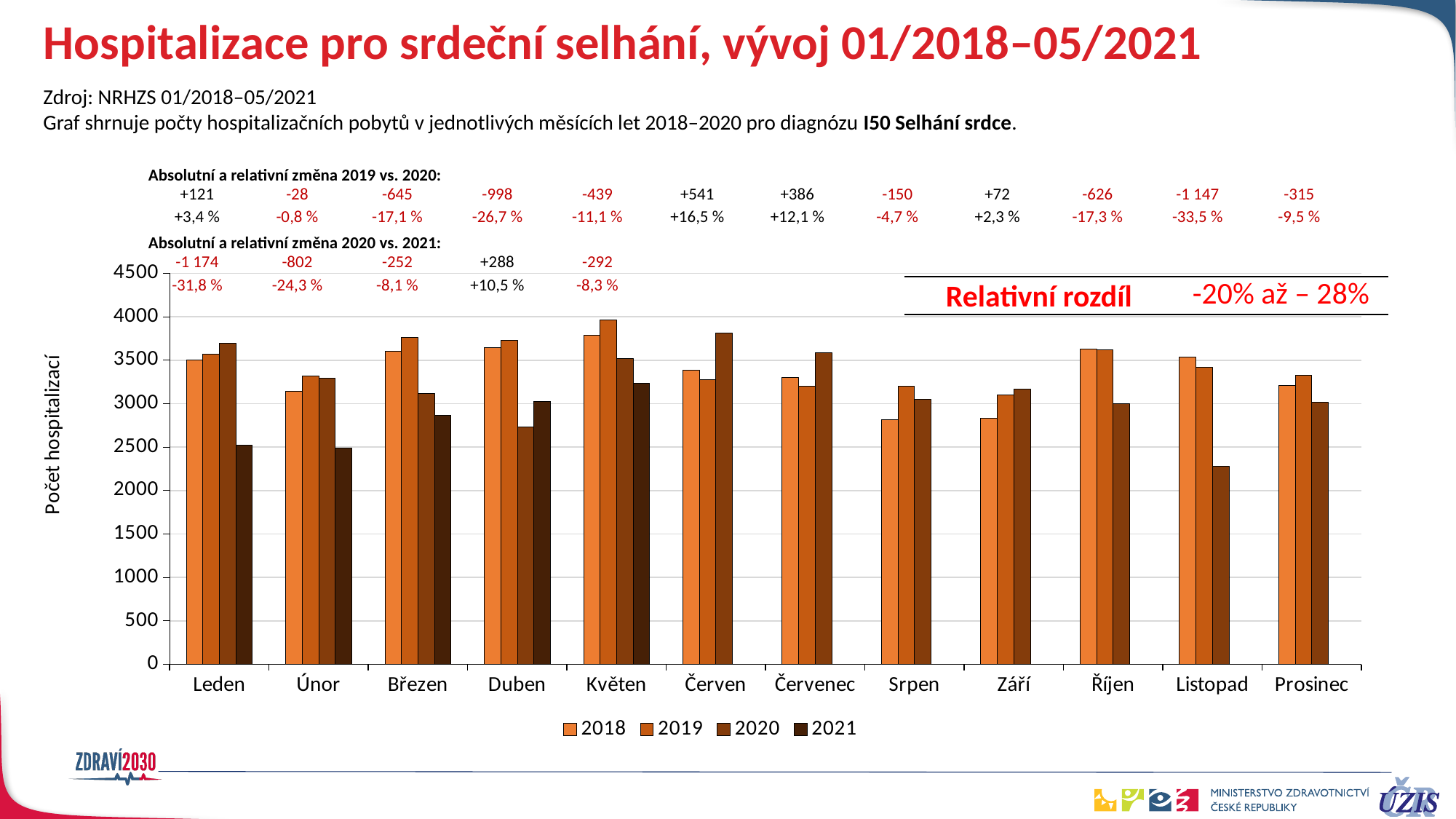
Which month has the lowest value for the 2021 series? Únor Is the value for Červen in 2020 greater or less than 3500? greater Which month has the highest value for the 2019 series? Květen How many series does the legend list? 4 What is the label of the y axis? Počet hospitalizací In Březen, which is larger: the 2020 value or the 2021 value? 2020 What kind of chart is shown on the slide? bar chart How many months (categories) are shown on the x axis? 12 Which month has the highest value for the 2020 series? Červen According to the annotation above the chart, what is the absolute change 2019 vs. 2020 for Listopad? -1 147 Is the value for Duben in 2020 greater or less than 3000? less